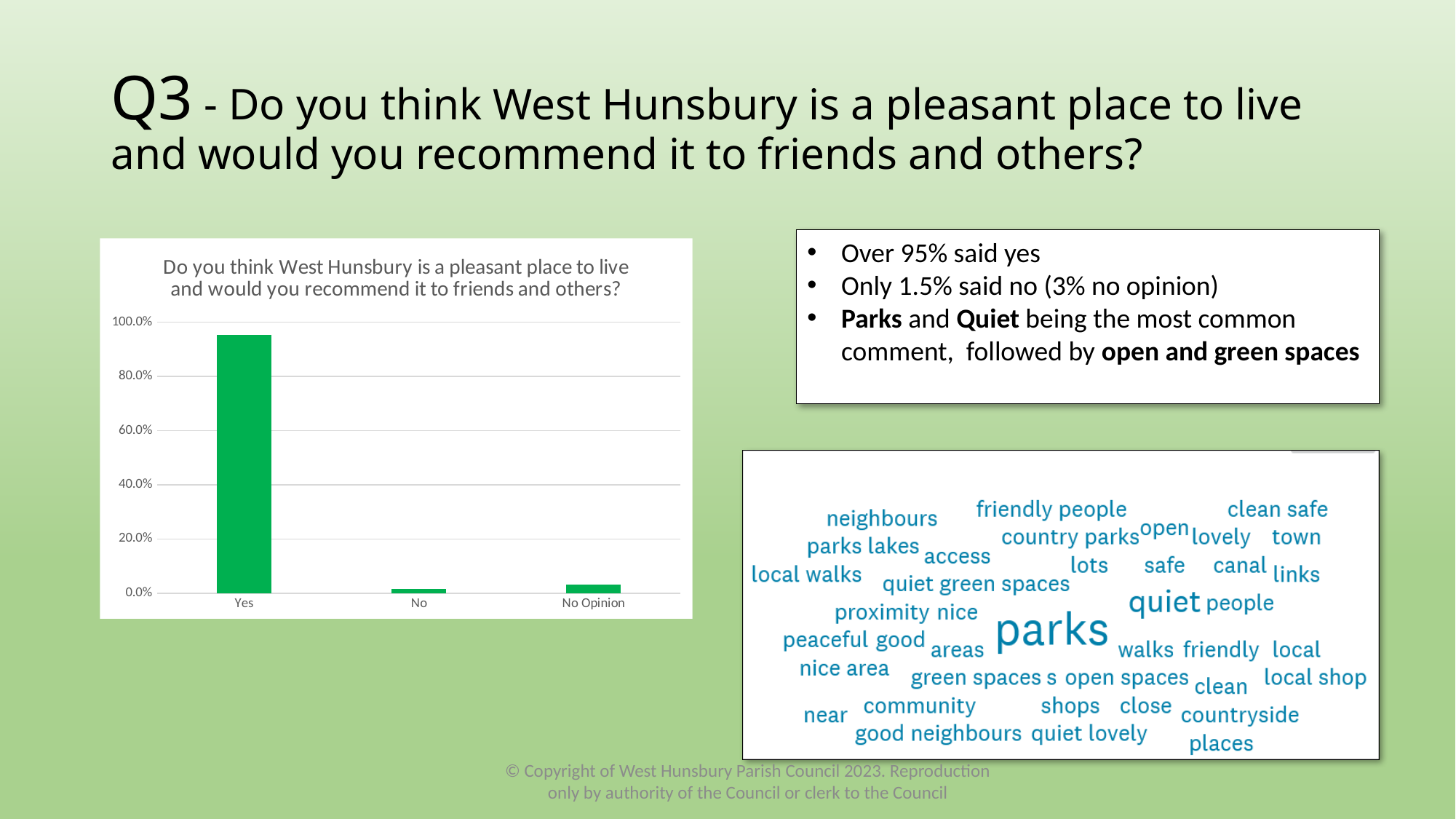
What colour are the bars in the chart? green Which is larger, the value for No or the value for No Opinion? No Opinion Is the value for No Opinion greater or less than 20.0%? less Which category has the highest bar in the chart? Yes Which is larger, the value for Yes or the value for No Opinion? Yes How many categories are shown on the x axis of the chart? 3 What kind of chart is shown on the slide? bar chart Is the value for No greater or less than 20.0%? less Which category has the lowest bar in the chart? No What is the highest tick label on the y axis of the chart? 100.0% Is the value for Yes greater or less than 80.0%? greater